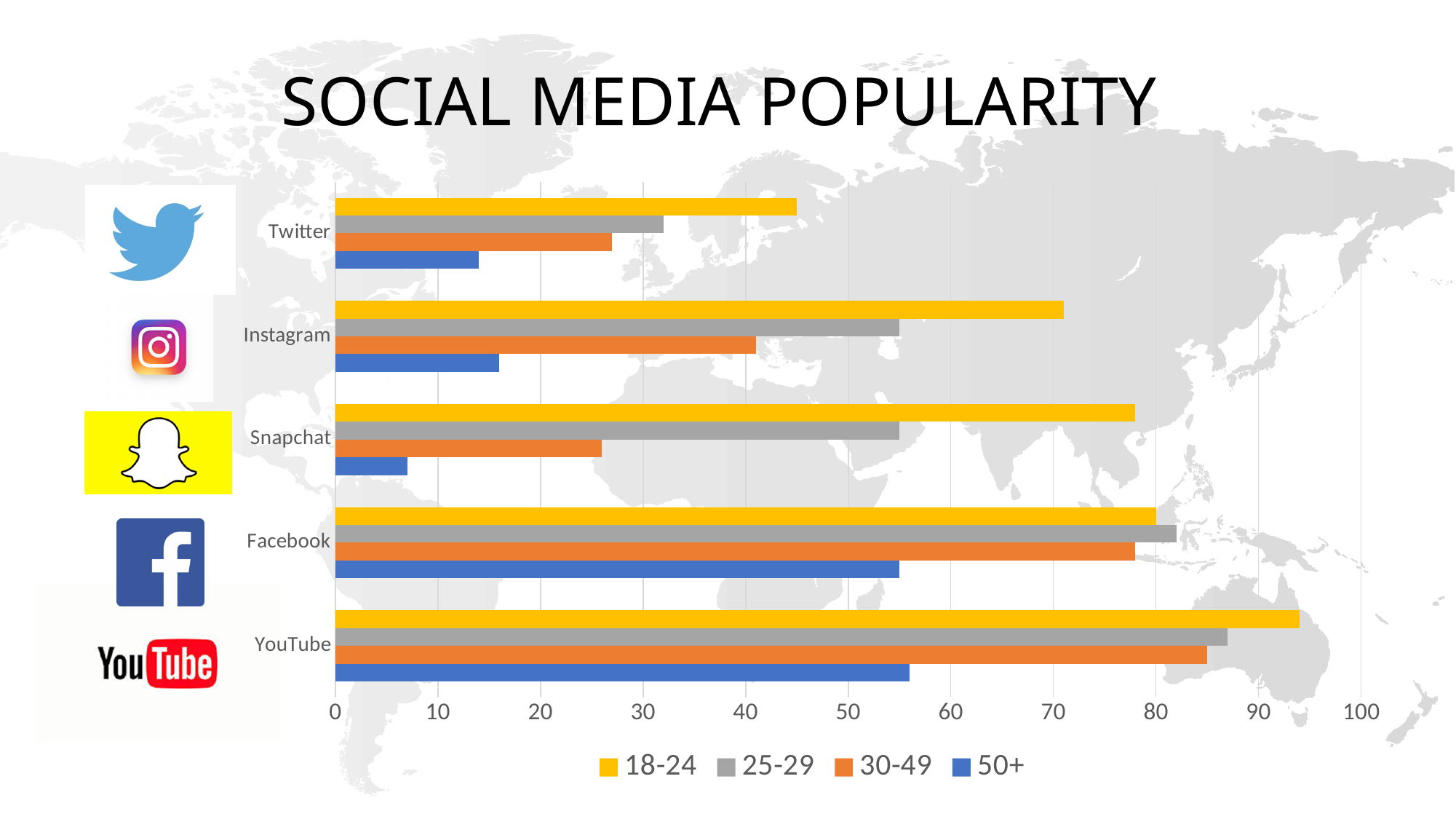
What kind of chart is shown on the slide? bar chart Which is larger for the 50+ age group: Facebook or Snapchat? Facebook Is the value for Twitter in the 18-24 age group greater or less than 40? greater Which platform has the highest value for the 18-24 age group? YouTube Is the value for Instagram in the 50+ age group greater or less than 20? less Which is larger for the 18-24 age group: Instagram or Twitter? Instagram Is the value for YouTube in the 18-24 age group greater or less than 90? greater What is the title of the slide? SOCIAL MEDIA POPULARITY Which platform has the lowest value for the 50+ age group? Snapchat How many social media platforms are plotted on the chart? 5 What colour represents the 50+ age group in the legend? blue How many age-group series does the legend list? 4